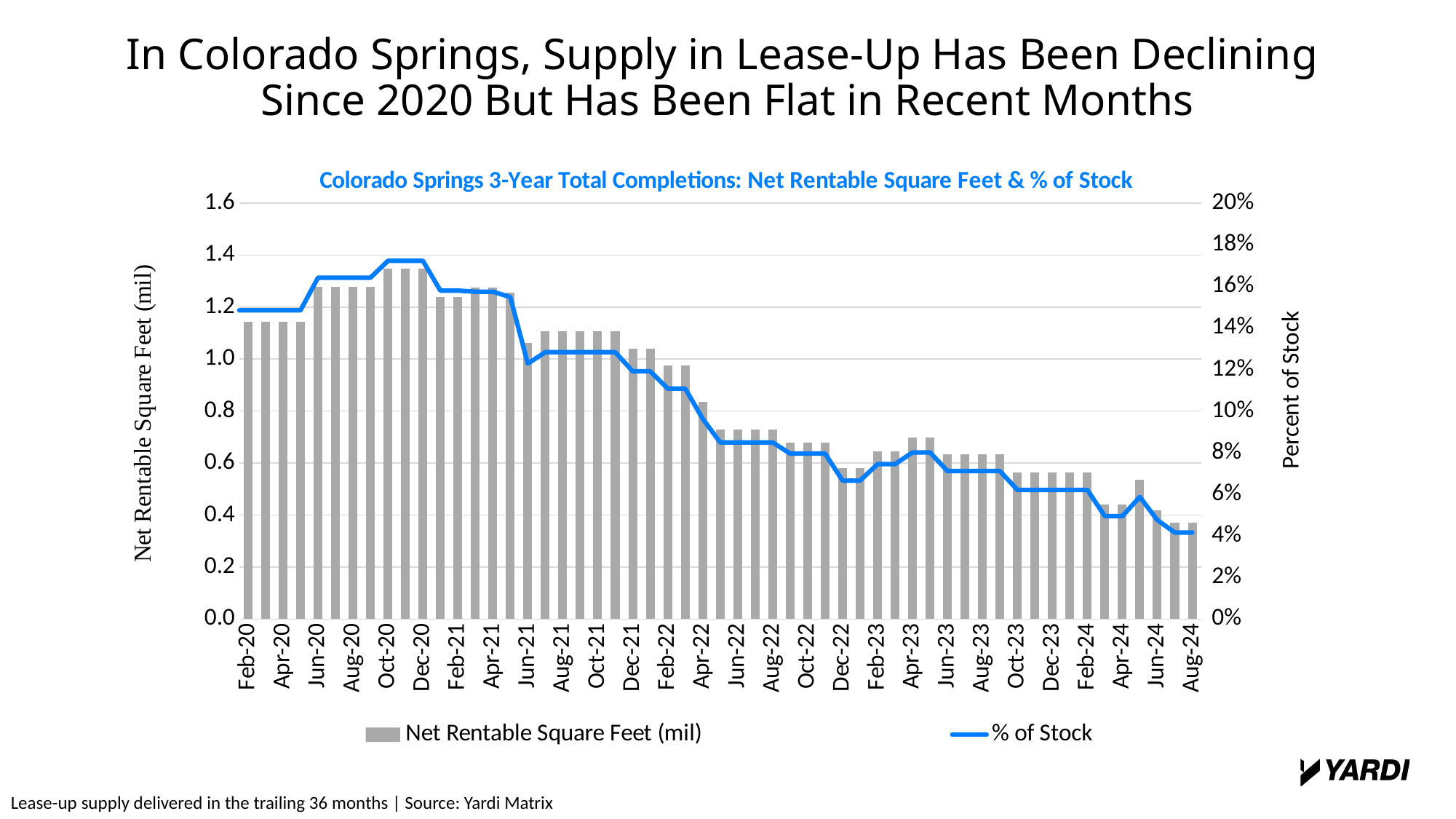
What is the label on the right-hand vertical axis? Percent of Stock Is the Net Rentable Square Feet (mil) value for Oct-20 greater or less than 1.2? greater How many series does the legend list? 2 Is the Net Rentable Square Feet (mil) value for Feb-20 greater or less than 1.0? greater Is the % of Stock value for Aug-24 greater or less than 6%? less What kind of chart is shown on the slide? A combination bar and line chart What are the two series named in the legend? Net Rentable Square Feet (mil) and % of Stock Which has the larger Net Rentable Square Feet (mil) value, Feb-20 or Aug-24? Feb-20 Which has the larger Net Rentable Square Feet (mil) value, Jun-21 or Jun-22? Jun-21 Overall, does the % of Stock line rise or fall from Feb-20 to Aug-24? Fall